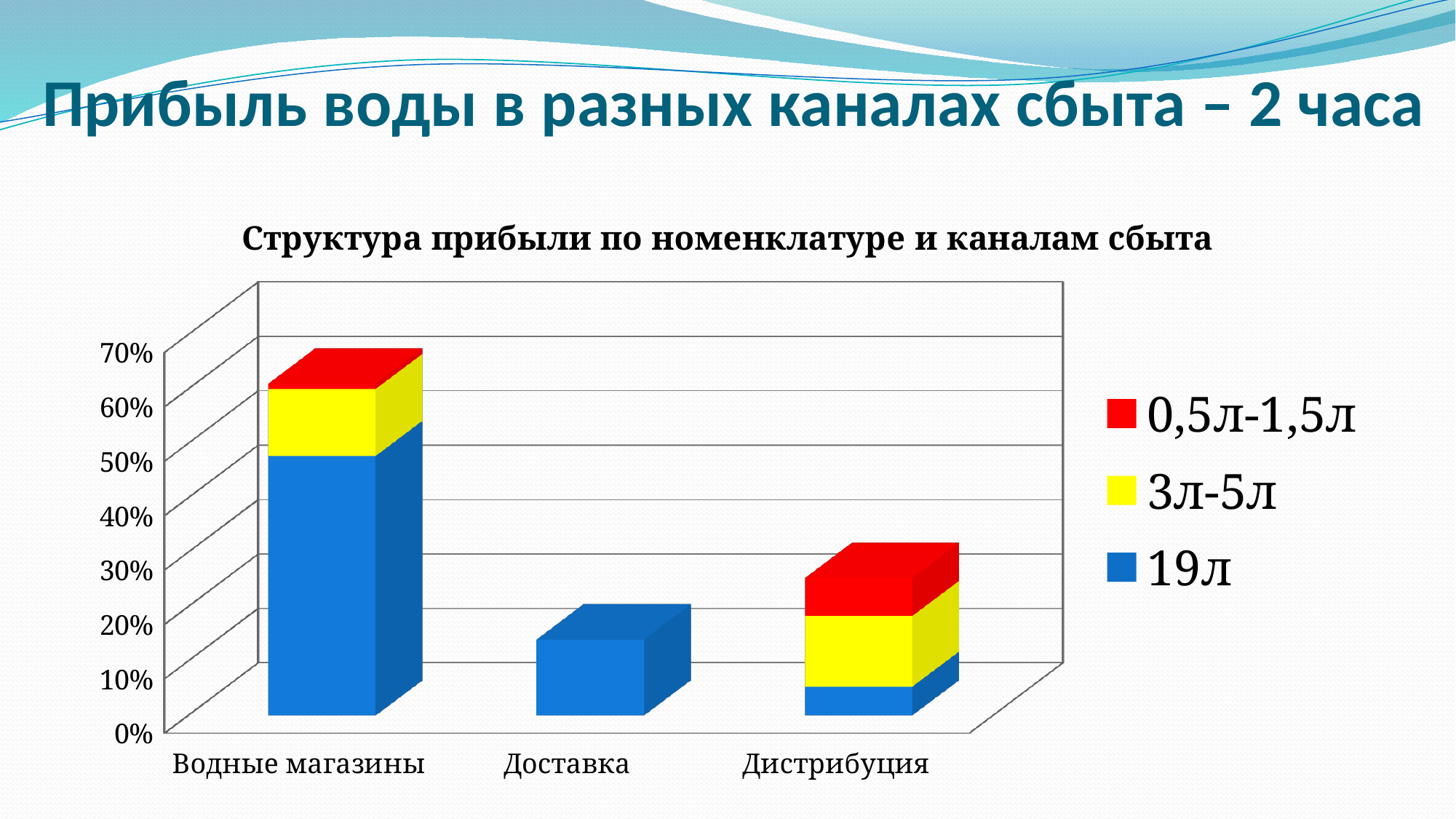
What is the title of the chart? Структура прибыли по номенклатуре и каналам сбыта Is the total value for Водные магазины greater or less than 50%? greater Which category has the highest total bar? Водные магазины Which series is the only one shown in the Доставка bar? 19л Is the value for Доставка greater or less than 20%? less What type of chart is shown on the slide? bar chart Which category has the lowest total bar? Доставка Is the total value for Дистрибуция greater or less than 40%? less Which has a larger total bar, Доставка or Дистрибуция? Дистрибуция How many categories are shown on the x axis of the chart? 3 How many series does the legend list? 3 Which has a larger total bar, Водные магазины or Дистрибуция? Водные магазины